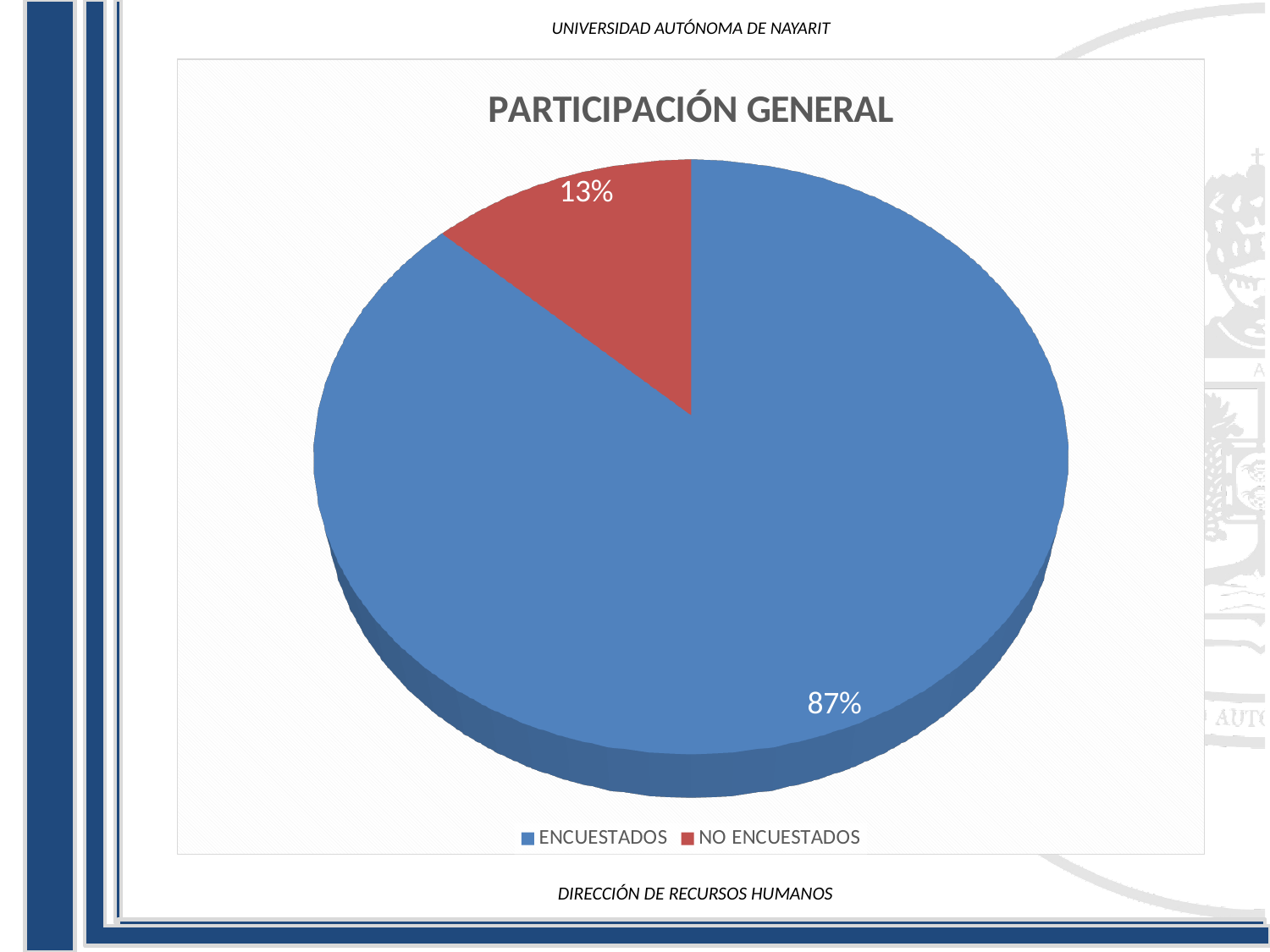
What type of chart is shown on the slide? pie chart What colour is the NO ENCUESTADOS slice? red How many categories does the legend list? 2 Which category has the smallest share of the pie? NO ENCUESTADOS Is the share for ENCUESTADOS greater or less than 50%? greater What percentage of the pie is NO ENCUESTADOS? 13% What is the title of the chart? PARTICIPACIÓN GENERAL Which is larger, the share for ENCUESTADOS or the share for NO ENCUESTADOS? ENCUESTADOS What percentage of the pie is ENCUESTADOS? 87% What is the difference in percentage points between ENCUESTADOS and NO ENCUESTADOS? 74 Which category has the largest share of the pie? ENCUESTADOS